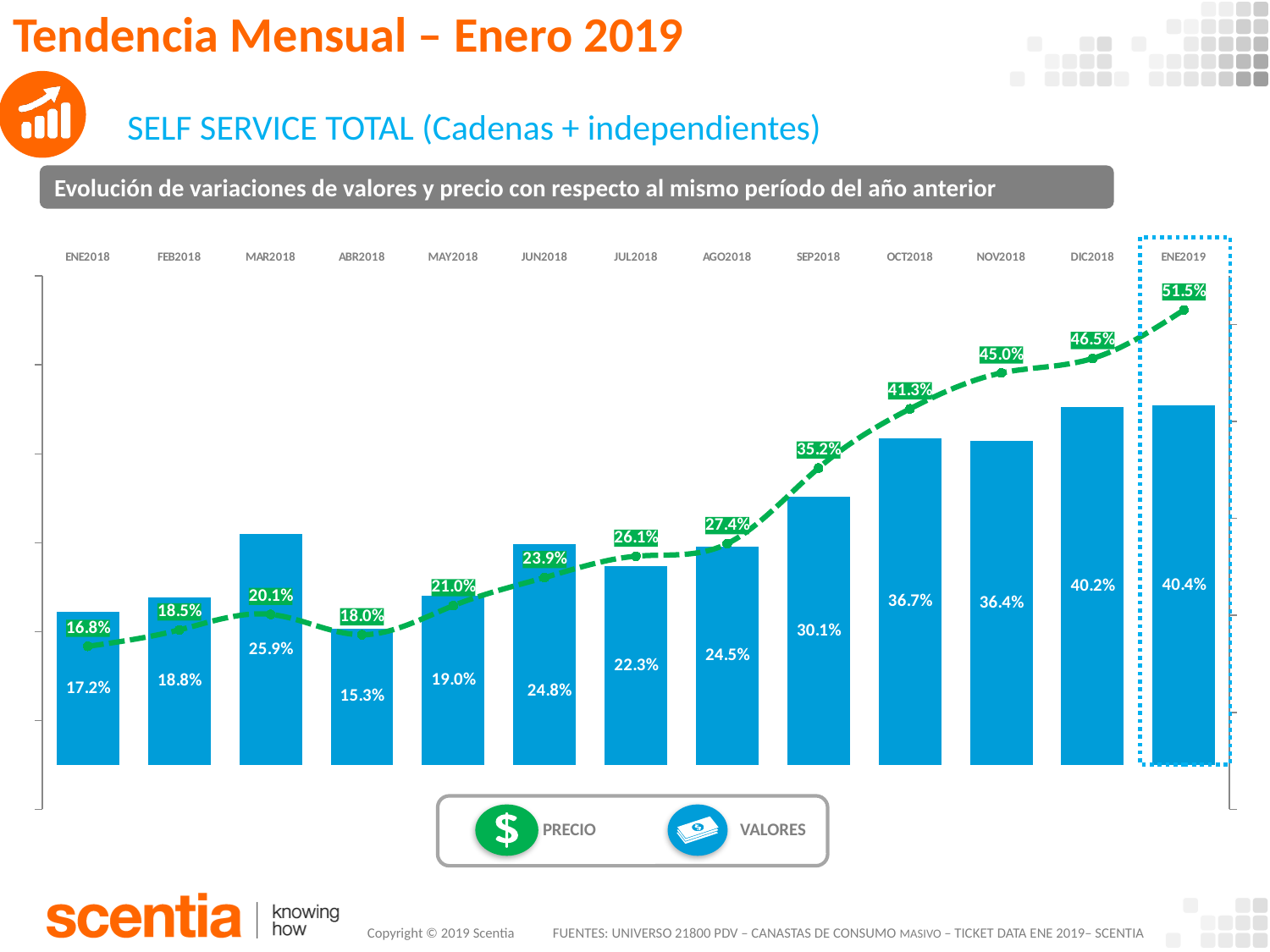
What is the VALORES value for ENE2019? 40.4% Does the PRECIO line generally rise or fall from ENE2018 to ENE2019? Rise What kind of chart is shown on the slide? Combined bar and line chart How many months are shown on the x axis? 13 How many series does the legend list? 2 Which series is shown as a green dashed line? PRECIO Which month has the lowest VALORES value? ABR2018 Which is larger, the VALORES value for OCT2018 or the VALORES value for NOV2018? OCT2018 What is the PRECIO value for SEP2018? 35.2% What is the difference between the PRECIO value for ENE2019 and the PRECIO value for DIC2018? 5.0% Which month has the highest PRECIO value? ENE2019 What is the VALORES value for ABR2018? 15.3%